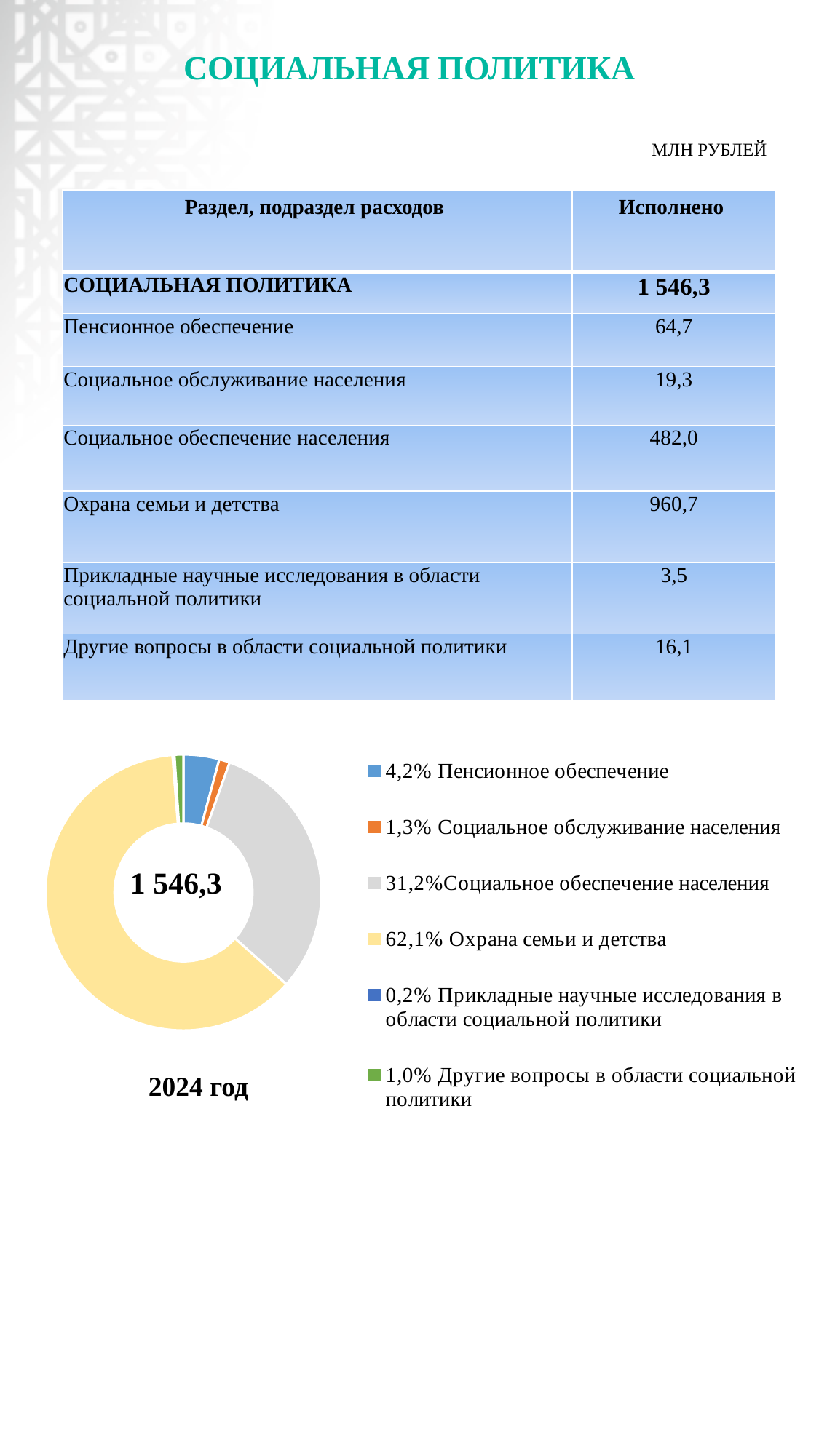
What share of the doughnut chart does Социальное обслуживание населения take? 1,3% What share of the doughnut chart does Прикладные научные исследования в области социальной политики take? 0,2% What share of the doughnut chart does Пенсионное обеспечение take? 4,2% What kind of chart is shown at the bottom of the slide? Doughnut (pie) chart How many categories does the legend of the doughnut chart list? 6 Which slice is larger in the doughnut chart: Пенсионное обеспечение or Другие вопросы в области социальной политики? Пенсионное обеспечение Which category has the smallest slice in the doughnut chart? Прикладные научные исследования в области социальной политики What total value is shown in the centre of the doughnut chart? 1 546,3 What year is labelled under the doughnut chart? 2024 год Which category has the largest slice in the doughnut chart? Охрана семьи и детства